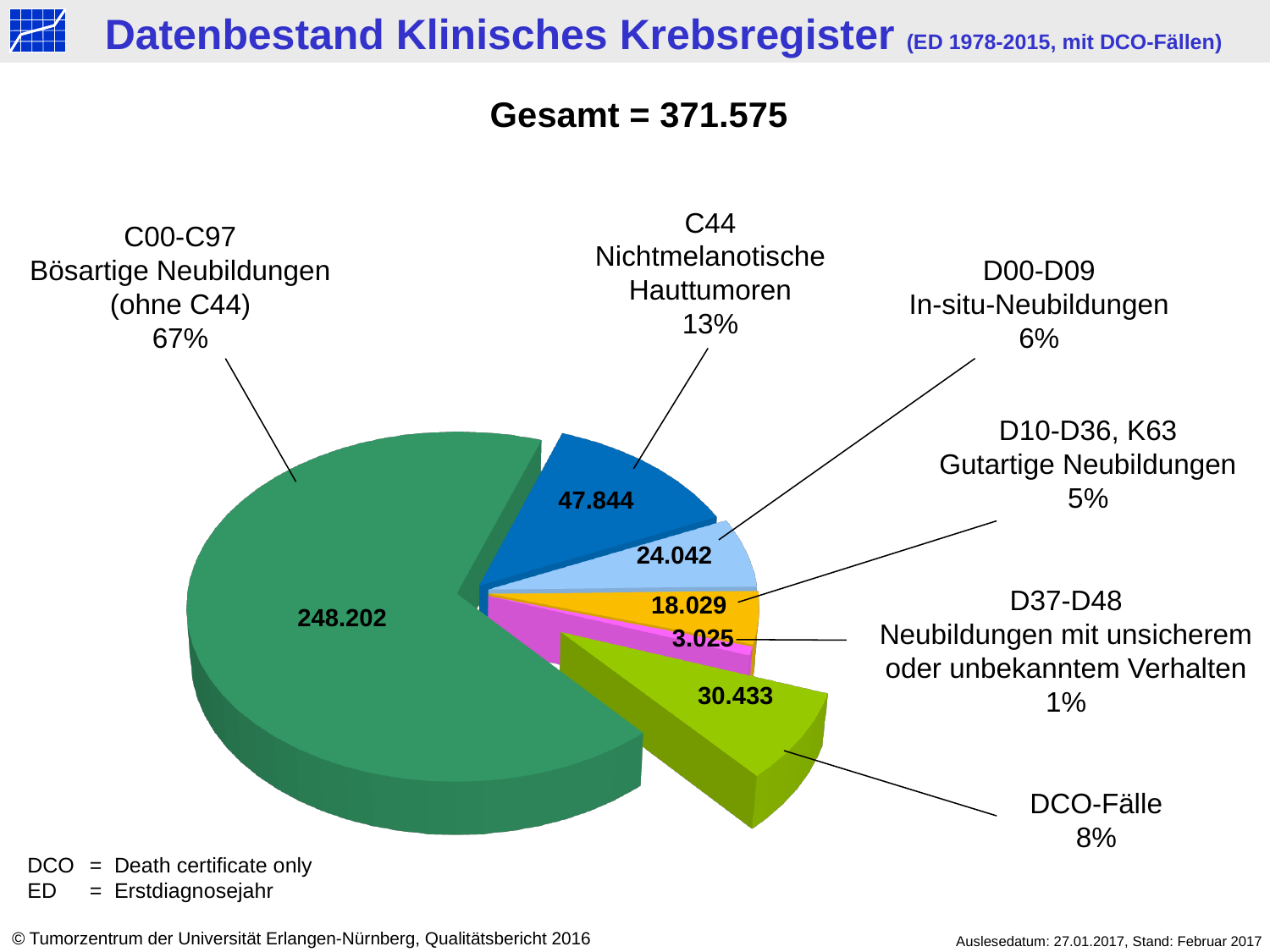
What is the value for C00-C97 Bösartige Neubildungen (ohne C44)? 248.202 What is the value for DCO-Fälle? 30.433 Which category has the smallest slice of the pie? D37-D48 Neubildungen mit unsicherem oder unbekanntem Verhalten How many slices does the pie chart have? 6 Which category has the largest slice of the pie? C00-C97 Bösartige Neubildungen (ohne C44) What share of the pie does DCO-Fälle represent? 8% What is the difference between the value for D00-D09 In-situ-Neubildungen and the value for D10-D36, K63 Gutartige Neubildungen? 6.013 What is the value for C44 Nichtmelanotische Hauttumoren? 47.844 Which is larger, the value for C44 Nichtmelanotische Hauttumoren or the value for DCO-Fälle? C44 Nichtmelanotische Hauttumoren What kind of chart is shown on the slide? pie chart What share of the pie does D10-D36, K63 Gutartige Neubildungen represent? 5% What is the value for D00-D09 In-situ-Neubildungen? 24.042